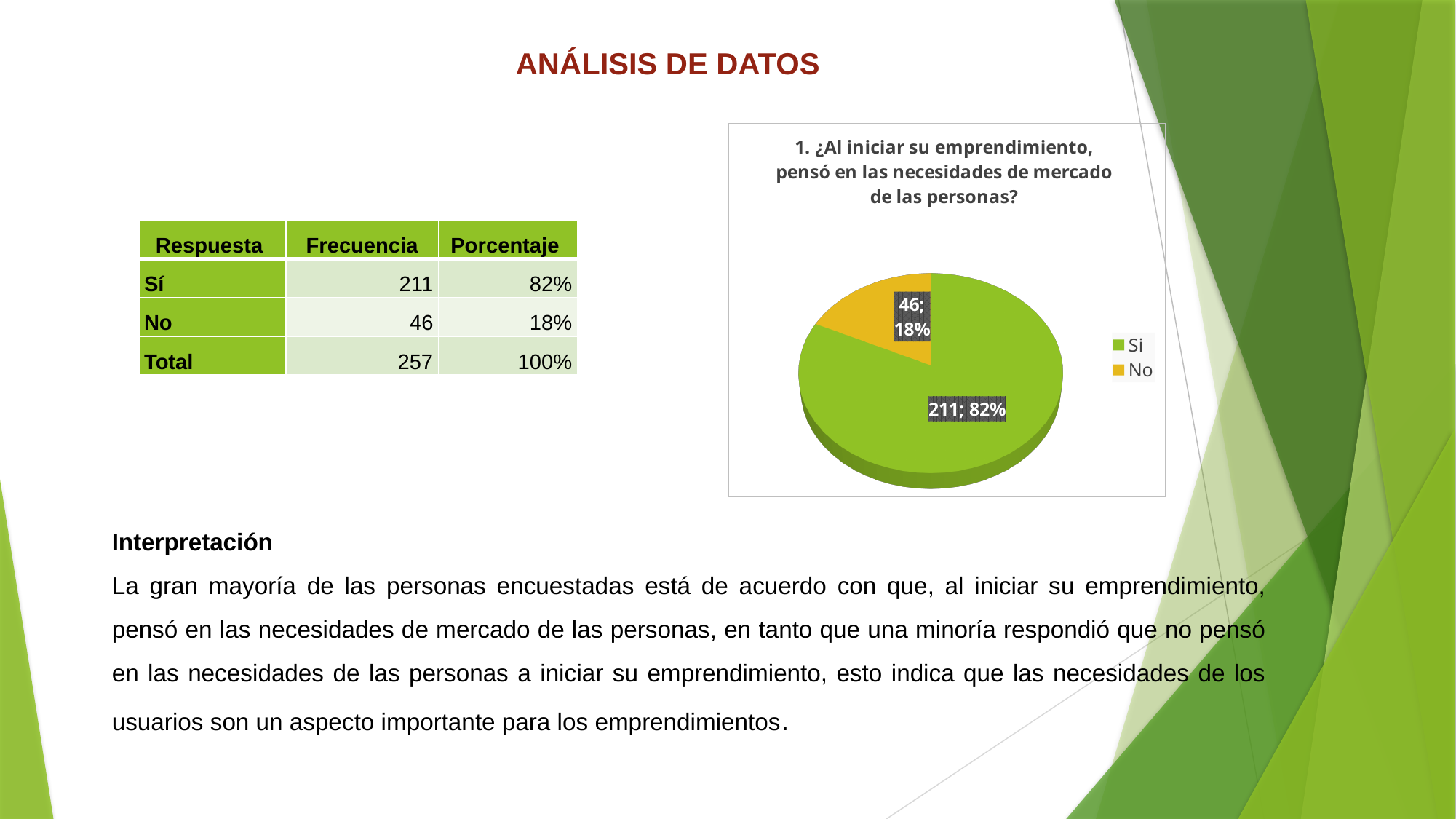
What share of the pie does the 'No' slice represent? 18% What colour is the 'No' slice in the pie chart? Yellow What is the difference in frequency between the 'Si' and 'No' slices? 165 Which slice of the pie chart is the smallest? No How many slices does the pie chart have? 2 What is the frequency value shown for the 'No' slice in the pie chart? 46 What is the frequency value shown for the 'Si' slice in the pie chart? 211 Which is larger in the pie chart, the 'Si' slice or the 'No' slice? Si Which slice of the pie chart is the largest? Si How many entries does the legend of the pie chart list? 2 What share of the pie does the 'Si' slice represent? 82% What kind of chart is shown on the slide? Pie chart